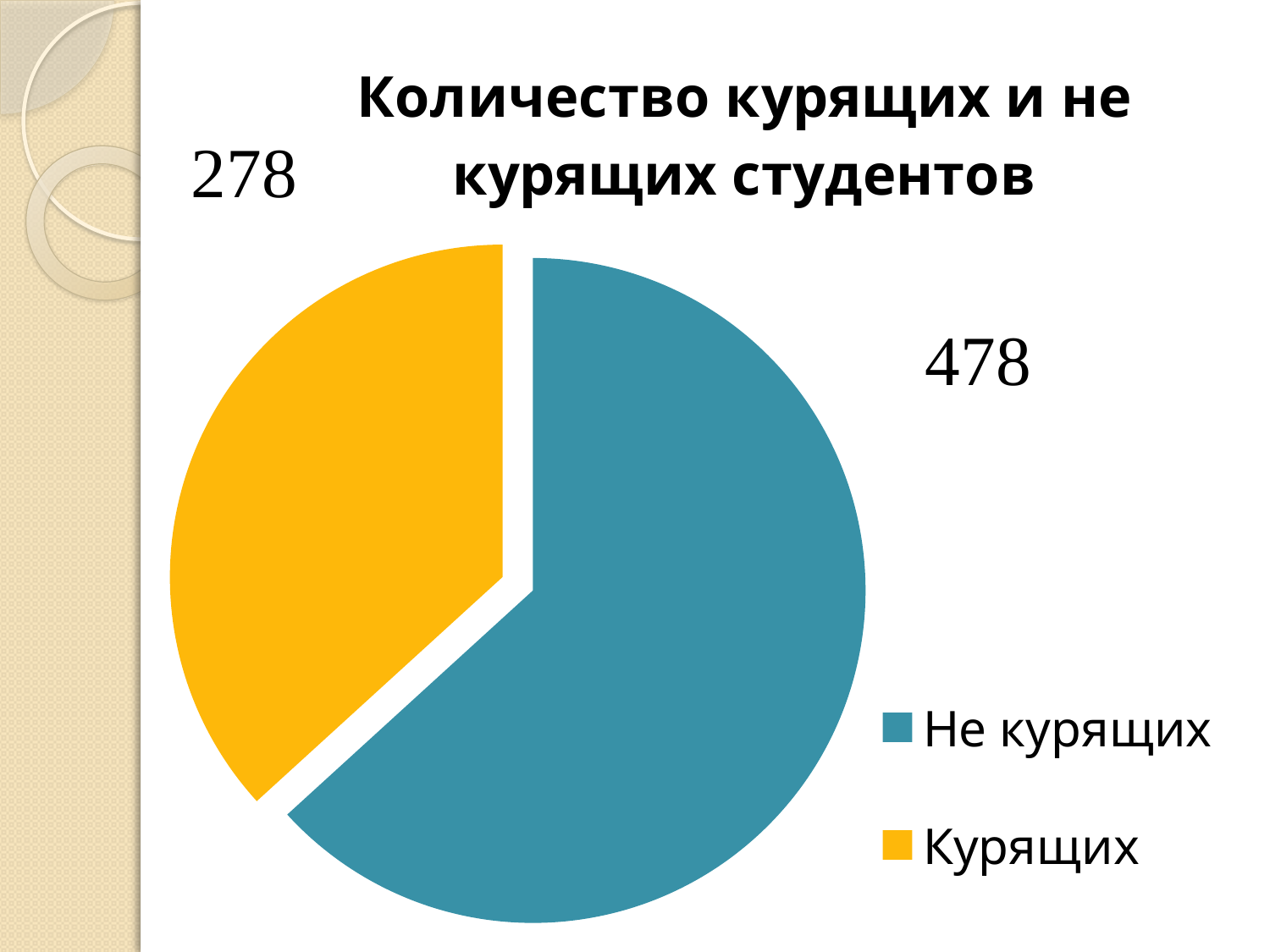
What is the value for Курящих? 278 Which category has the smallest slice? Курящих What is the title of the chart? Количество курящих и не курящих студентов Which category has the largest slice? Не курящих What kind of chart is shown on the slide? Pie chart Which is larger, the value for Не курящих or the value for Курящих? Не курящих What is the difference between the values for Не курящих and Курящих? 200 What colour is the slice for Курящих? Yellow What is the total of all slices in the pie chart? 756 What is the value for Не курящих? 478 How many slices does the pie chart have? 2 How many entries does the legend list? 2